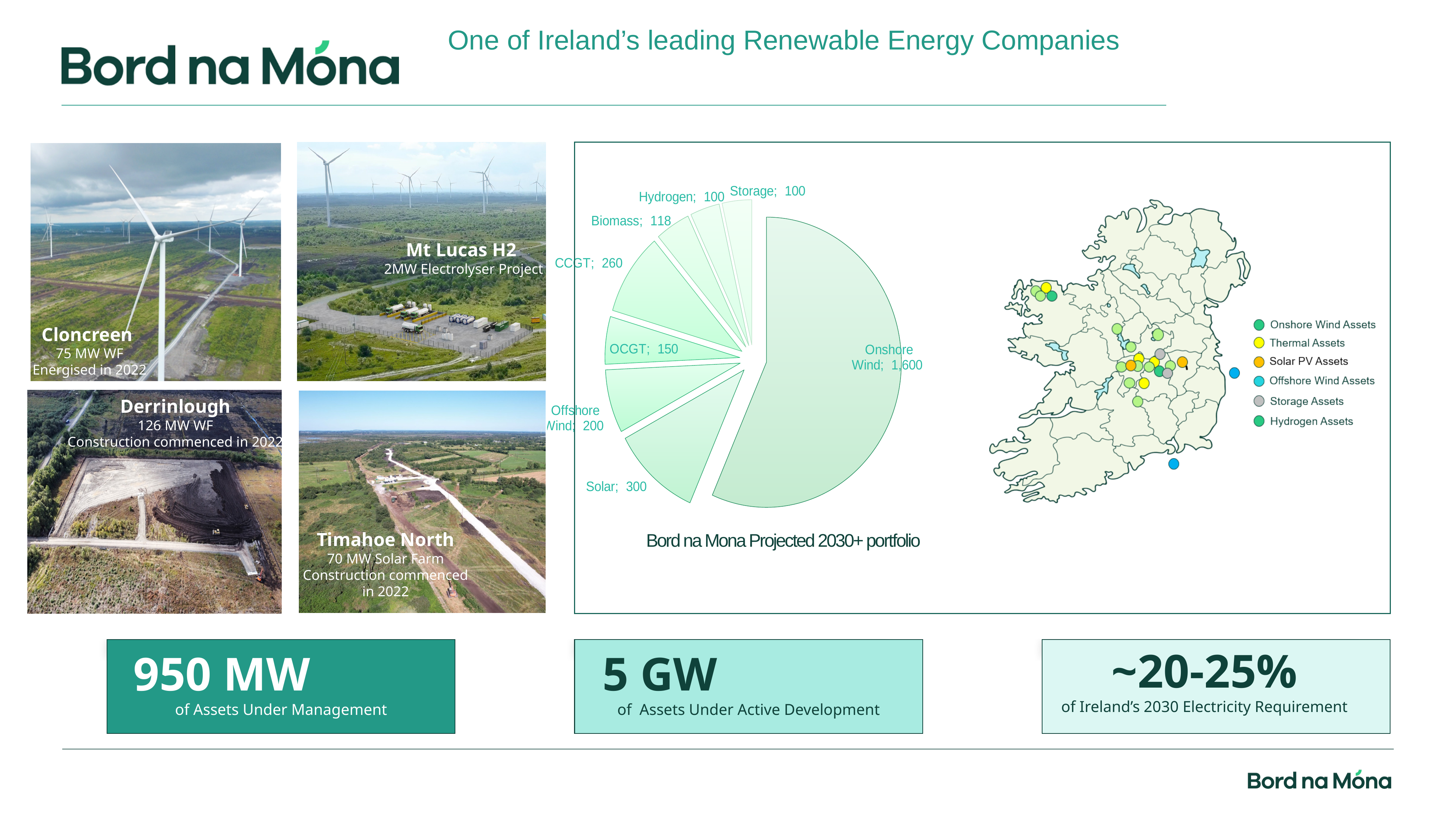
Which category has the largest slice in the pie chart? Onshore Wind What is the difference between the Solar and Offshore Wind values in the pie chart? 100 What is the value for Biomass in the pie chart? 118 What is the value for CCGT in the pie chart? 260 What is the value for Onshore Wind in the pie chart? 1,600 What is the value for Solar in the pie chart? 300 What is the title of the pie chart? Bord na Mona Projected 2030+ portfolio What kind of chart is used to show the projected 2030+ portfolio? Pie chart What is the difference between the CCGT and OCGT values in the pie chart? 110 In the pie chart, which is larger: CCGT or Solar? Solar How many categories are shown in the pie chart? 8 What is the value for Offshore Wind in the pie chart? 200